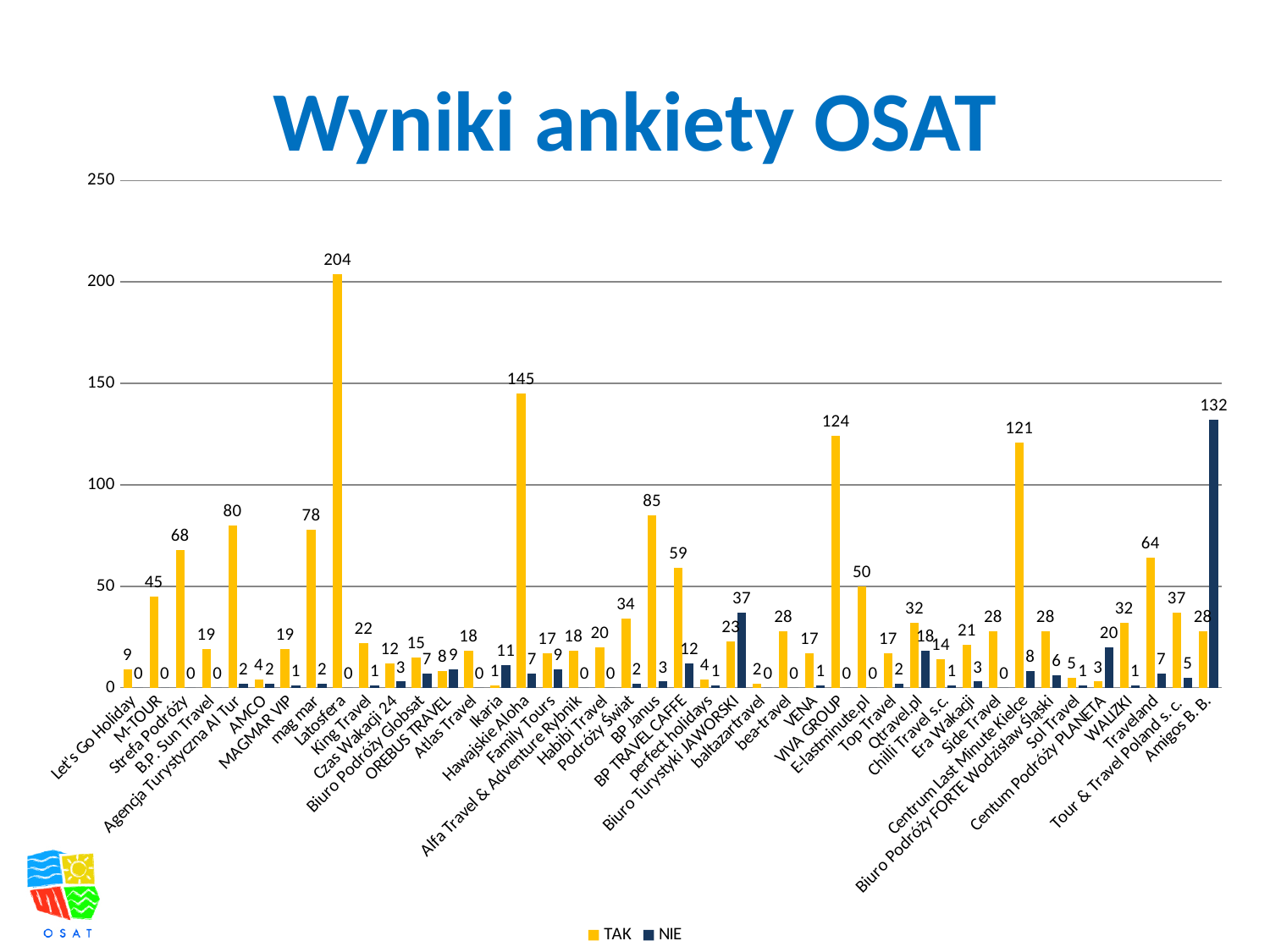
Which has the larger TAK value, VIVA GROUP or Centrum Last Minute Kielce? VIVA GROUP What is the difference between the TAK values for Latosfera and Hawajskie Aloha? 59 Which category has the highest TAK value? Latosfera What is the TAK value for BP Janus? 85 What is the TAK value for Latosfera? 204 Which category has the highest NIE value? Amigos B. B. For Biuro Turystyki JAWORSKI, which is larger, the TAK value or the NIE value? NIE What kind of chart is shown on the slide? bar chart What is the TAK value for Hawajskie Aloha? 145 What are the two series named in the legend? TAK and NIE How many series does the legend list? 2 What is the NIE value for Amigos B. B.? 132